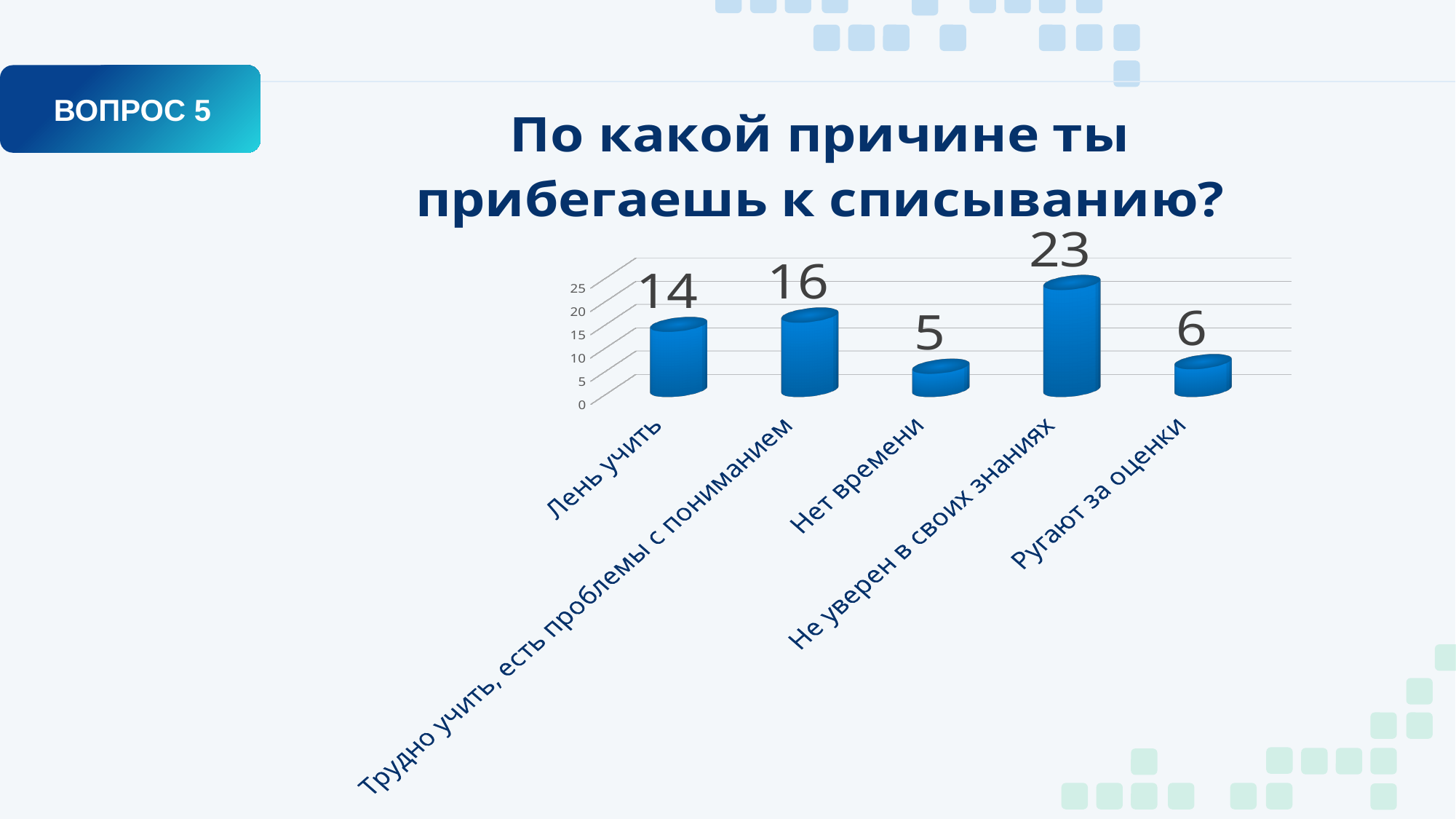
What is the difference between the values for "Не уверен в своих знаниях" and "Лень учить"? 9 What is the value for "Трудно учить, есть проблемы с пониманием"? 16 Which category has the lowest value? Нет времени What is the value for "Лень учить"? 14 Which is larger: the value for "Трудно учить, есть проблемы с пониманием" or the value for "Лень учить"? Трудно учить, есть проблемы с пониманием What is the value for "Ругают за оценки"? 6 What kind of chart is shown on the slide? Bar chart Which category has the highest value? Не уверен в своих знаниях What is the value for "Не уверен в своих знаниях"? 23 What is the value for "Нет времени"? 5 What is the title of the chart? По какой причине ты прибегаешь к списыванию? How many categories are shown in the chart? 5